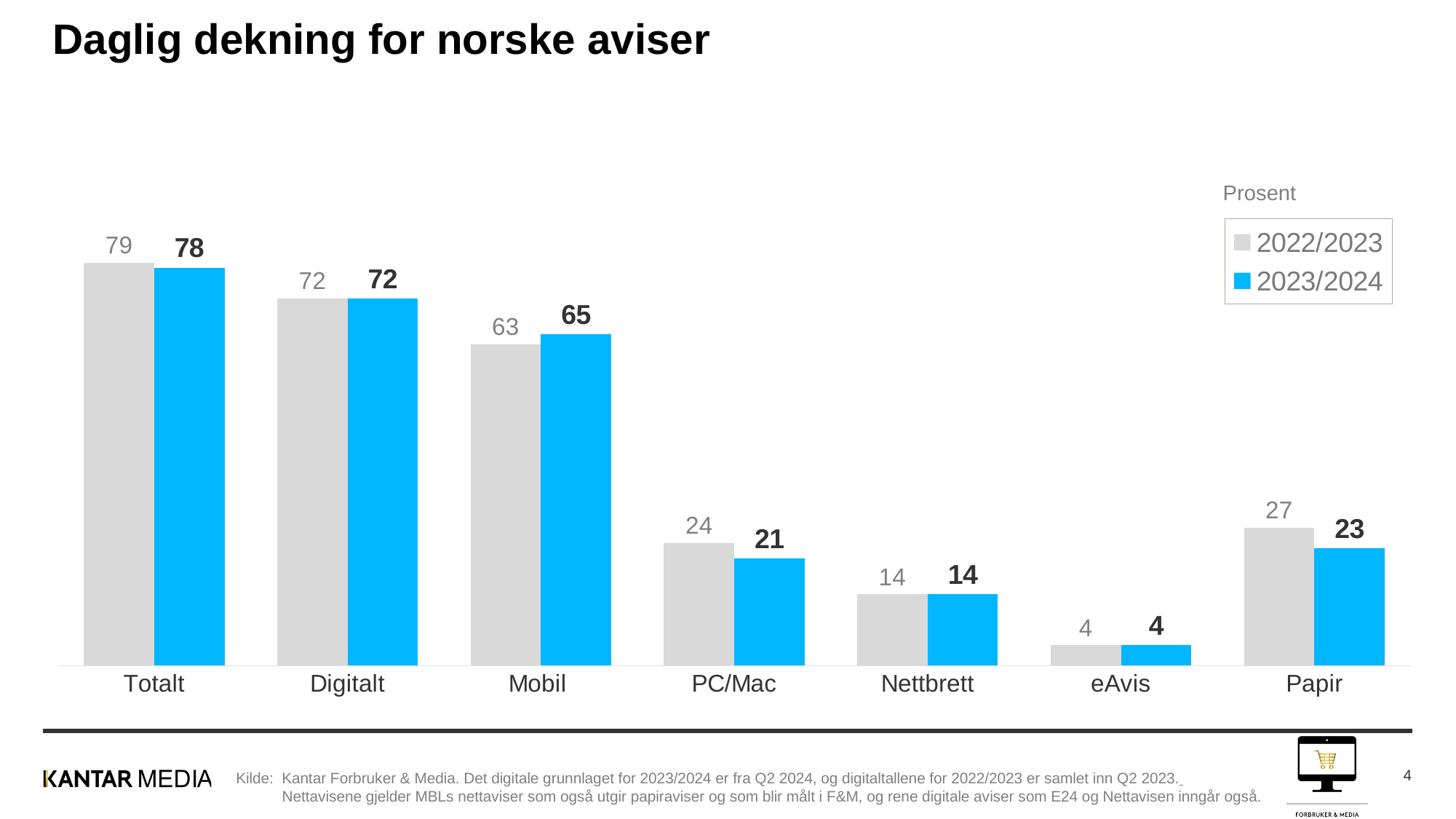
What is the value for Papir in the 2023/2024 series? 23 What is the difference between the 2023/2024 values for Digitalt and Mobil? 7 What is the value for PC/Mac in the 2022/2023 series? 24 What kind of chart is shown on the slide? Bar chart Which category has the highest value in the 2023/2024 series? Totalt What is the value for Mobil in the 2023/2024 series? 65 What is the difference between the 2022/2023 and 2023/2024 values for Papir? 4 Which is larger for Mobil: the 2022/2023 value or the 2023/2024 value? 2023/2024 How many series does the legend list? 2 Which category has the lowest value in the 2022/2023 series? eAvis How many categories are shown on the x axis? 7 What is the title of the chart? Daglig dekning for norske aviser